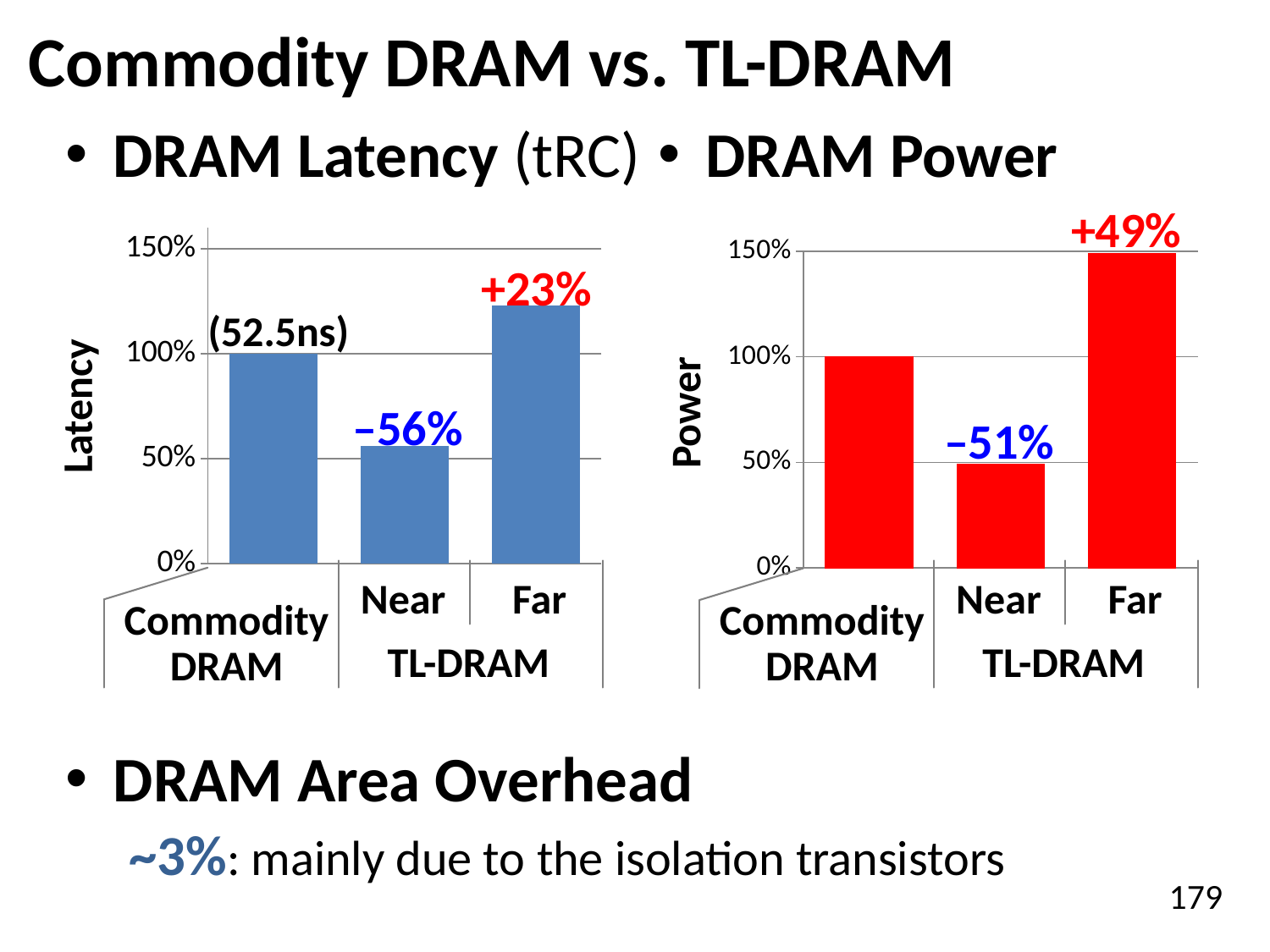
In the DRAM Latency chart, what label is printed above the Far bar? +23% In the DRAM Latency chart, is the value for Near greater or less than 50%? greater In the DRAM Latency chart, which bar is the highest? Far In the DRAM Power chart, which bar is the lowest? Near In the DRAM Latency chart, what absolute latency is noted next to the Commodity DRAM bar? (52.5ns) How many bars does the DRAM Power chart on the right have? 3 In the DRAM Latency chart, which bar is the lowest? Near What kind of chart is the DRAM Latency chart on the left? bar chart In the DRAM Latency chart, what is the value for Commodity DRAM? 100% In the DRAM Power chart, which bar is the highest? Far In the DRAM Power chart, what label is printed above the Near bar? –51% In the DRAM Power chart, is the value for Far greater or less than 100%? greater